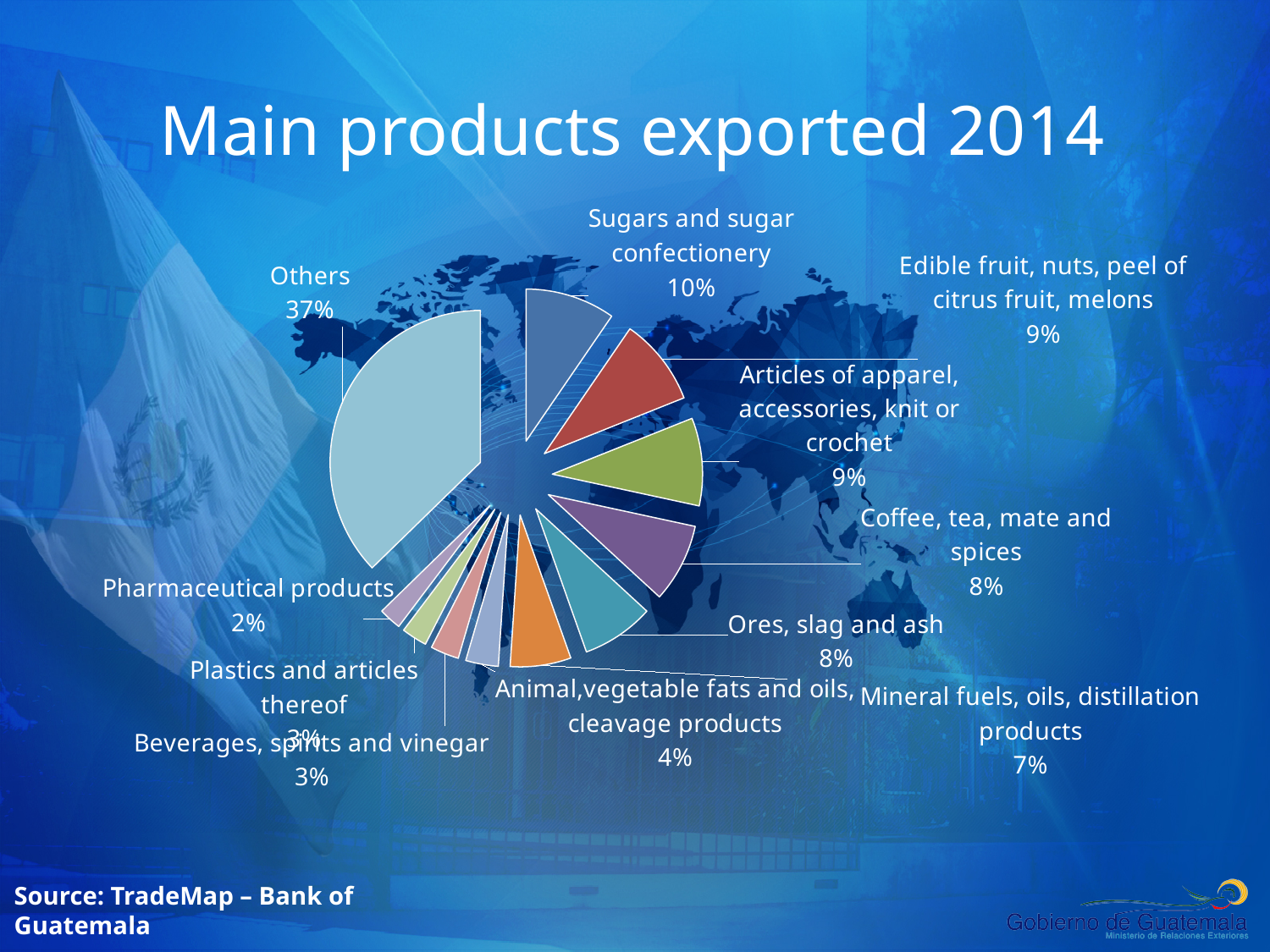
What kind of chart is shown on the slide? Pie chart What percentage is shown for Pharmaceutical products? 2% What percentage is shown for Mineral fuels, oils, distillation products? 7% What is the title of the chart? Main products exported 2014 What percentage is shown for Others? 37% Which category has the largest slice of the pie? Others What is the difference in percentage points between Sugars and sugar confectionery and Animal, vegetable fats and oils, cleavage products? 6 How many slices does the pie chart have? 11 Which category has the smallest slice of the pie? Pharmaceutical products What percentage is shown for Coffee, tea, mate and spices? 8% Which is larger, the share for Ores, slag and ash or the share for Beverages, spirits and vinegar? Ores, slag and ash What share of exports is labelled for Sugars and sugar confectionery? 10%